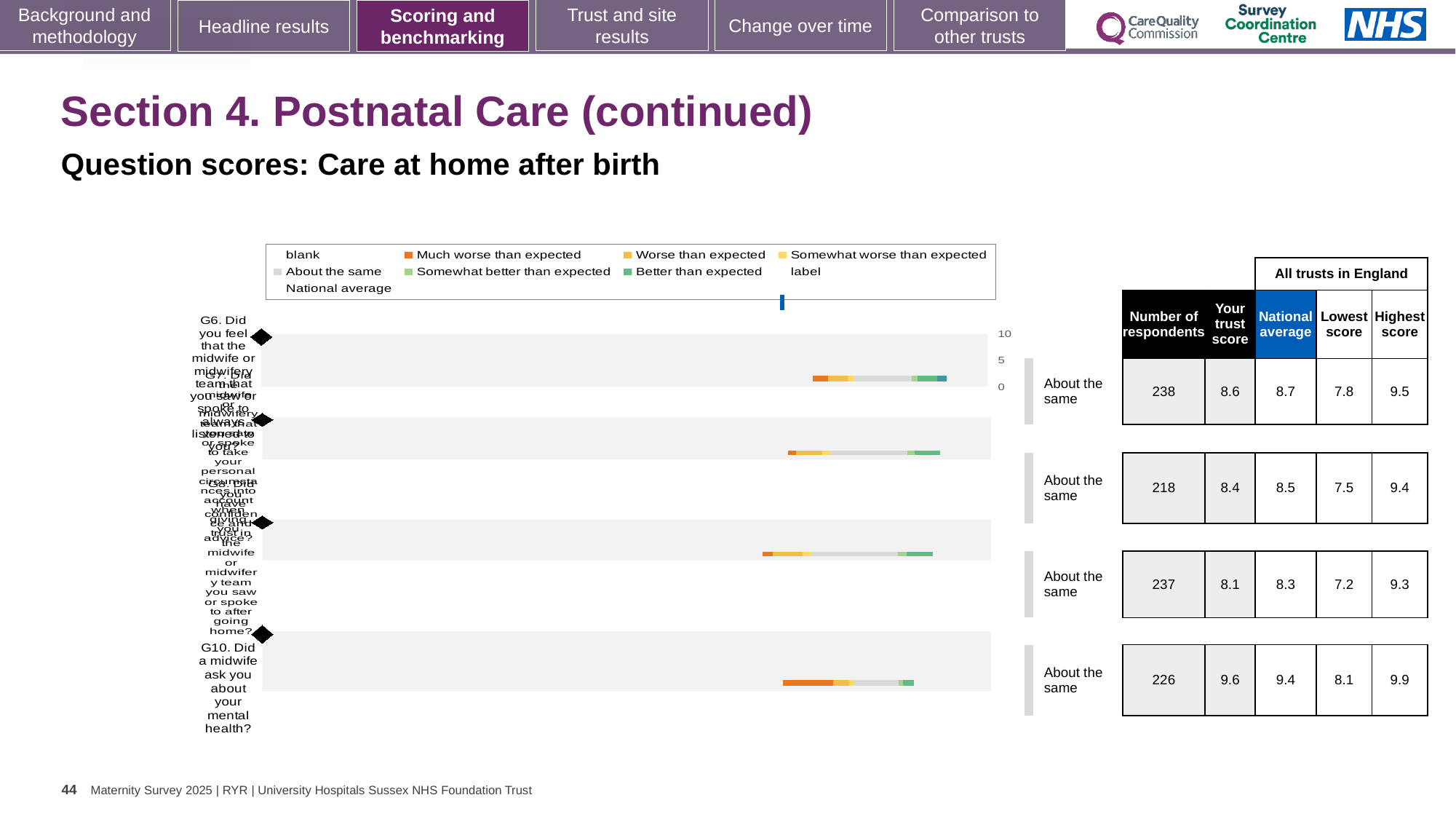
How many respondents answered G10 (Did a midwife ask you about your mental health?)? 226 What is the lowest score across all trusts in England for the first question row (G6)? 7.8 What is the number of respondents for the first question row (G6)? 238 What is the trust score for G10 (Did a midwife ask you about your mental health?)? 9.6 What colour represents 'Much worse than expected' in the legend? orange For G10, which is larger: the trust score or the national average? the trust score What benchmark category is shown for all four questions on the slide? About the same What is the difference between the highest score and the lowest score for G10? 1.8 What kind of chart is shown on the slide? bar chart How many questions are plotted on the chart? 4 Which question has the highest trust score? G10. Did a midwife ask you about your mental health? What is the national average for G10 (Did a midwife ask you about your mental health?)? 9.4